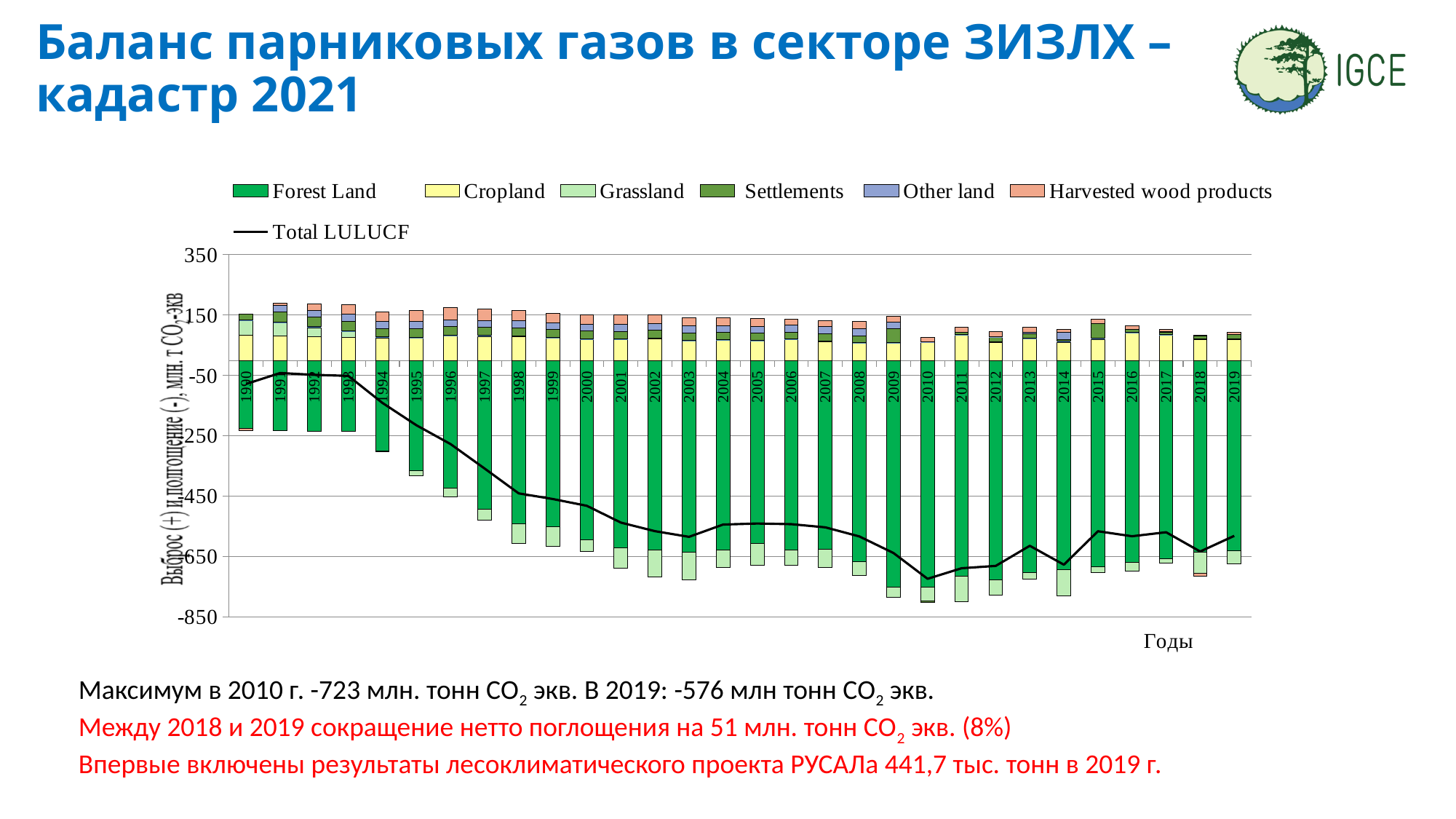
What is the label of the x axis of the chart? Годы What is the Total LULUCF value for 2010 according to the slide? -723 млн. тонн CO2 экв. Which year has the higher Total LULUCF value, 1994 or 1997? 1994 What is the Total LULUCF value for 2019 according to the slide? -576 млн тонн CO2 экв. What kind of chart is shown on the slide? A stacked bar chart combined with a line Is the Total LULUCF value for 1994 greater or less than -250? greater Is the Total LULUCF value for 2003 greater or less than -450? less In which year does the Total LULUCF line reach its lowest (most negative) value? 2010 By how much did net absorption decrease between 2018 and 2019 according to the slide? 51 млн. тонн CO2 экв. (8%) Does the Total LULUCF line rise or fall from 1990 to 2010? It falls How many series does the chart legend list? 7 How many years are plotted along the x axis of the chart? 30